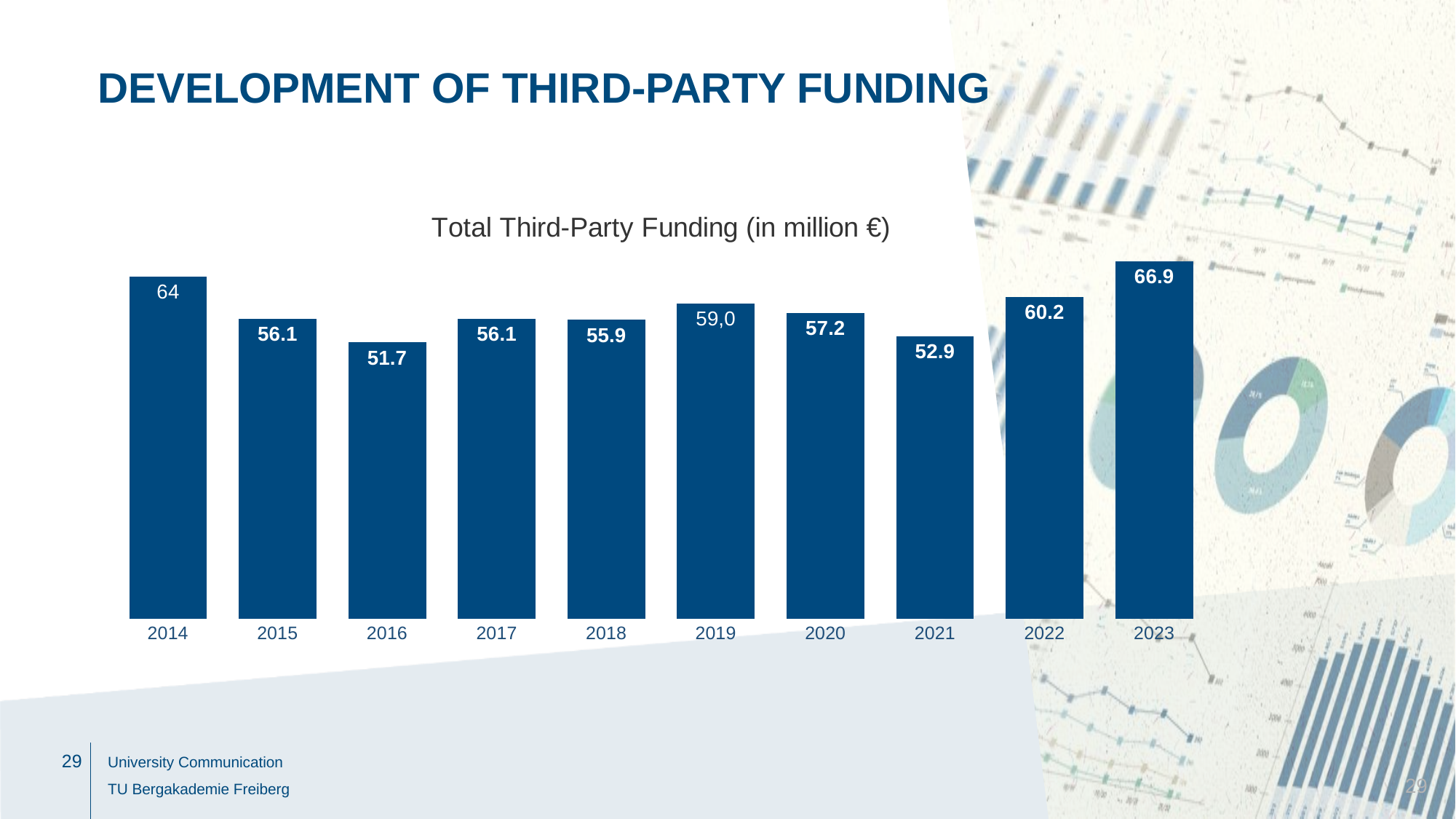
What is the value shown for 2019? 59,0 What kind of chart is shown on the slide? Bar chart What is the total third-party funding value shown for 2023? 66.9 Which year has the larger value, 2020 or 2018? 2020 By how much does the 2014 value exceed the 2021 value? 11.1 How many years are shown on the x axis of the chart? 10 What is the title of the chart? Total Third-Party Funding (in million €) What is the difference between the 2023 value and the 2022 value? 6.7 Which year has the lowest third-party funding? 2016 What value is labelled on the bar for 2016? 51.7 Do the values rise or fall from 2021 to 2023? Rise Which year has the highest third-party funding? 2023